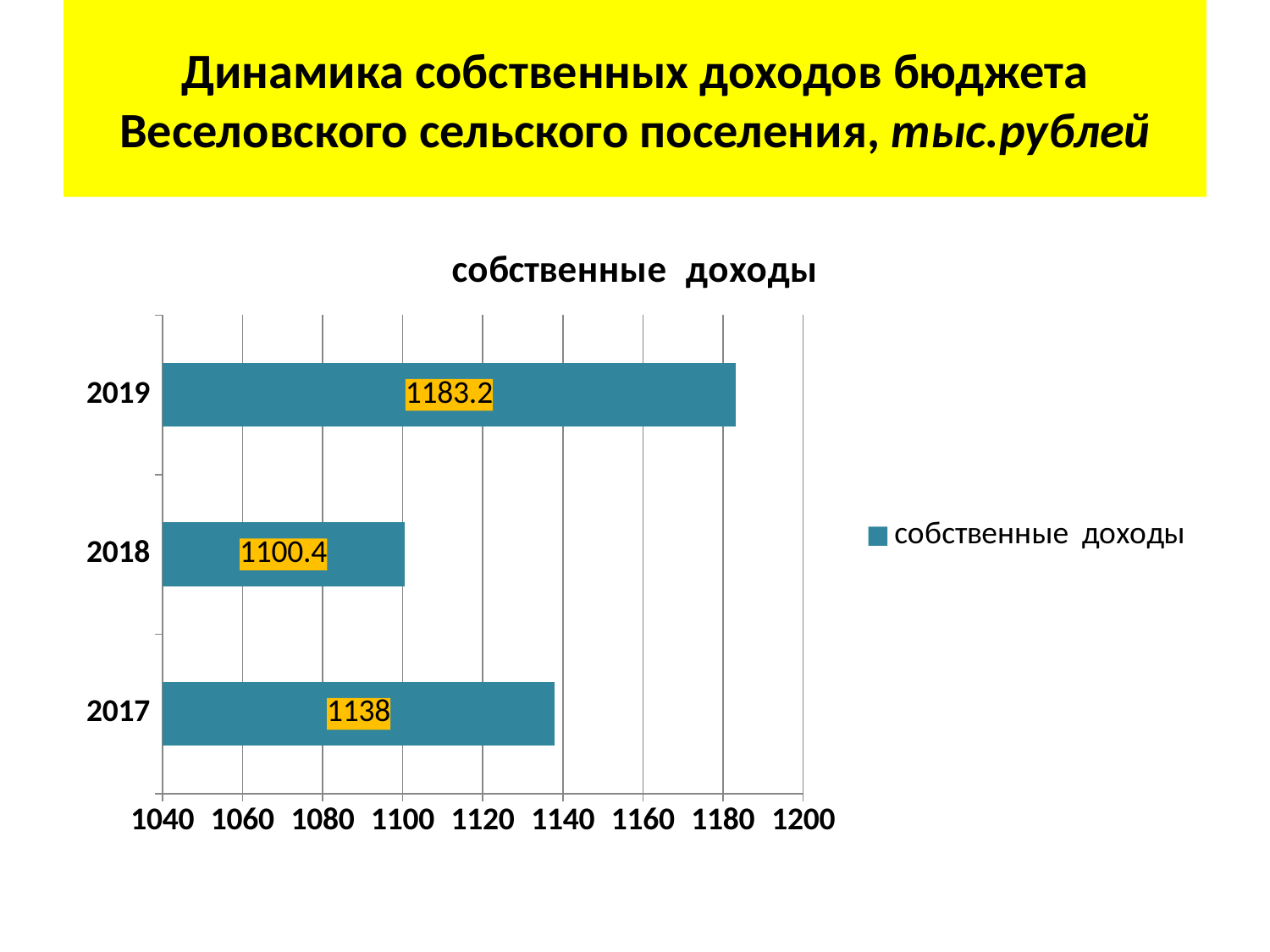
What is the title of the chart? собственные доходы What is the difference between the values for 2017 and 2018? 37.6 Is the value for 2019 greater or less than 1160? greater What is the value for 2019? 1183.2 What kind of chart is shown on the slide? bar chart What is the value for 2017? 1138 Which year has the lowest value? 2018 How many years are shown in the chart? 3 What is the value for 2018? 1100.4 What is the difference between the values for 2019 and 2018? 82.8 Which is larger, the value for 2017 or the value for 2018? 2017 Which year has the highest value? 2019